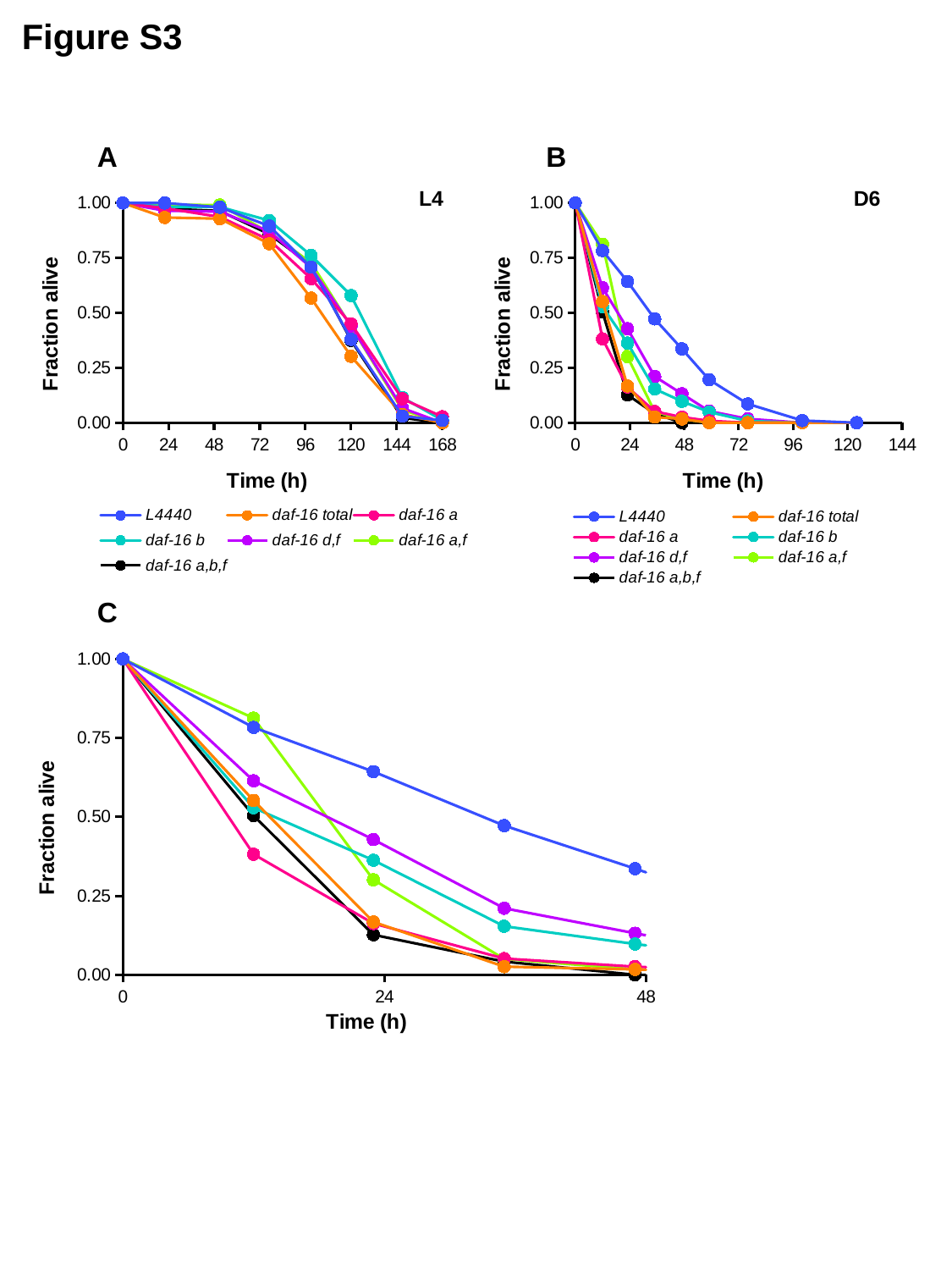
In chart A (L4), does the fraction alive for L4440 rise or fall as time increases? fall In chart B (D6), which series has the highest fraction alive at 72 h? L4440 In chart A (L4), what is the fraction alive for L4440 at time 0 h? 1.00 How many series does the legend of chart A (L4) list? 7 What kind of chart is chart A (L4)? line chart In chart B (D6), is the value for daf-16 a,b,f at 24 h greater or less than 0.25? less In chart A (L4), is the value for daf-16 total at 96 h greater or less than 0.75? less What is the largest tick value on the x axis of chart A (L4)? 168 In chart B (D6), at 48 h, which is larger: the value for L4440 or the value for daf-16 total? L4440 What is the y-axis title of chart C? Fraction alive In chart B (D6), is the value for L4440 at 24 h greater or less than 0.50? greater How many series does the legend of chart B (D6) list? 7